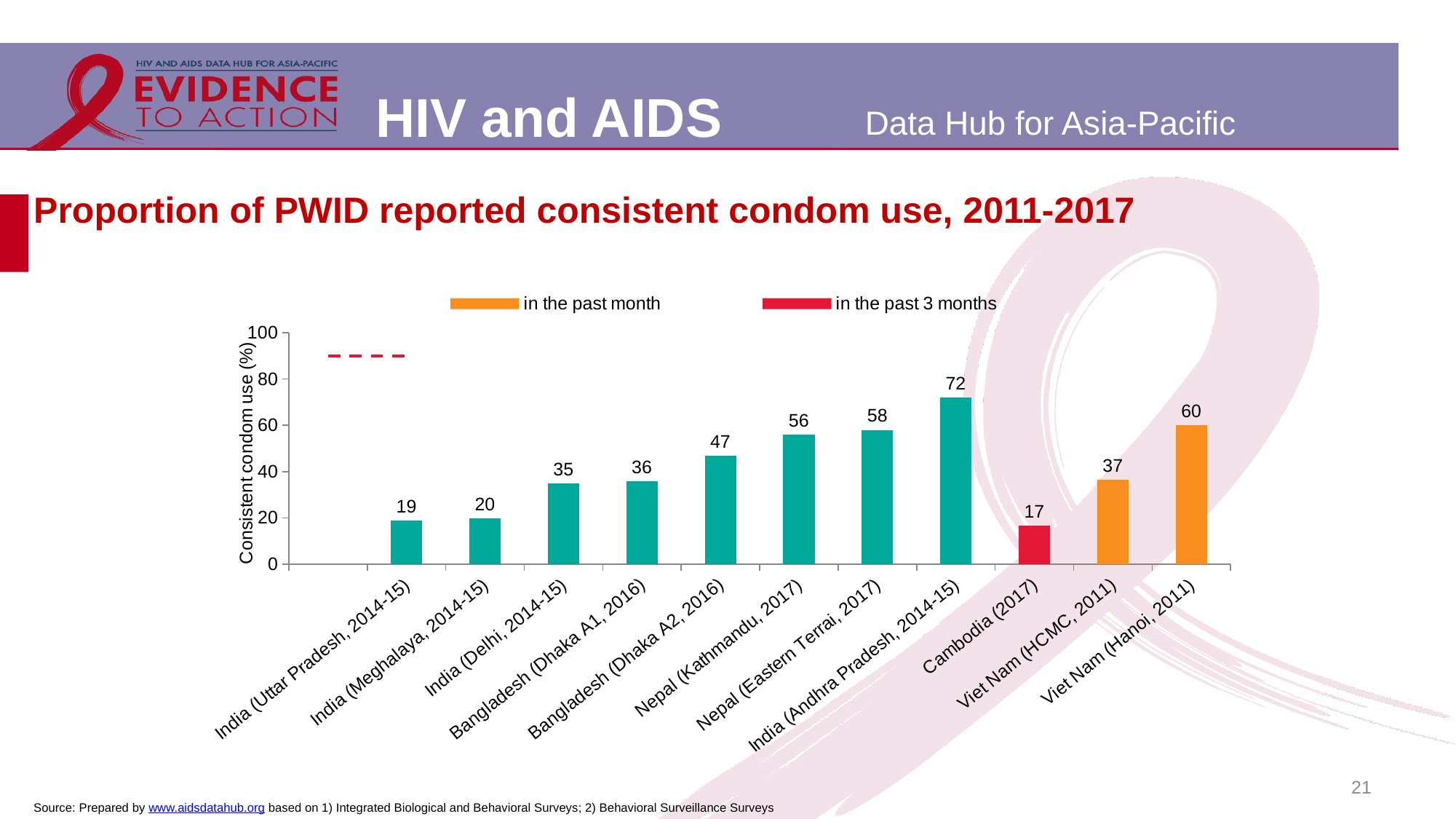
What is the difference between the values for India (Andhra Pradesh, 2014-15) and India (Uttar Pradesh, 2014-15)? 53 What is the value for Bangladesh (Dhaka A2, 2016)? 47 Is the value for India (Delhi, 2014-15) greater or less than 40? less Which category has the lowest value? Cambodia (2017) What is the value for Viet Nam (Hanoi, 2011)? 60 What is the title of the chart? Proportion of PWID reported consistent condom use, 2011-2017 What is the value for Nepal (Kathmandu, 2017)? 56 What kind of chart is shown on the slide? bar chart Which category has the highest value? India (Andhra Pradesh, 2014-15) How many categories are shown on the x axis? 11 How many entries does the legend list? 2 Which is larger, the value for Viet Nam (HCMC, 2011) or the value for Nepal (Eastern Terrai, 2017)? Nepal (Eastern Terrai, 2017)